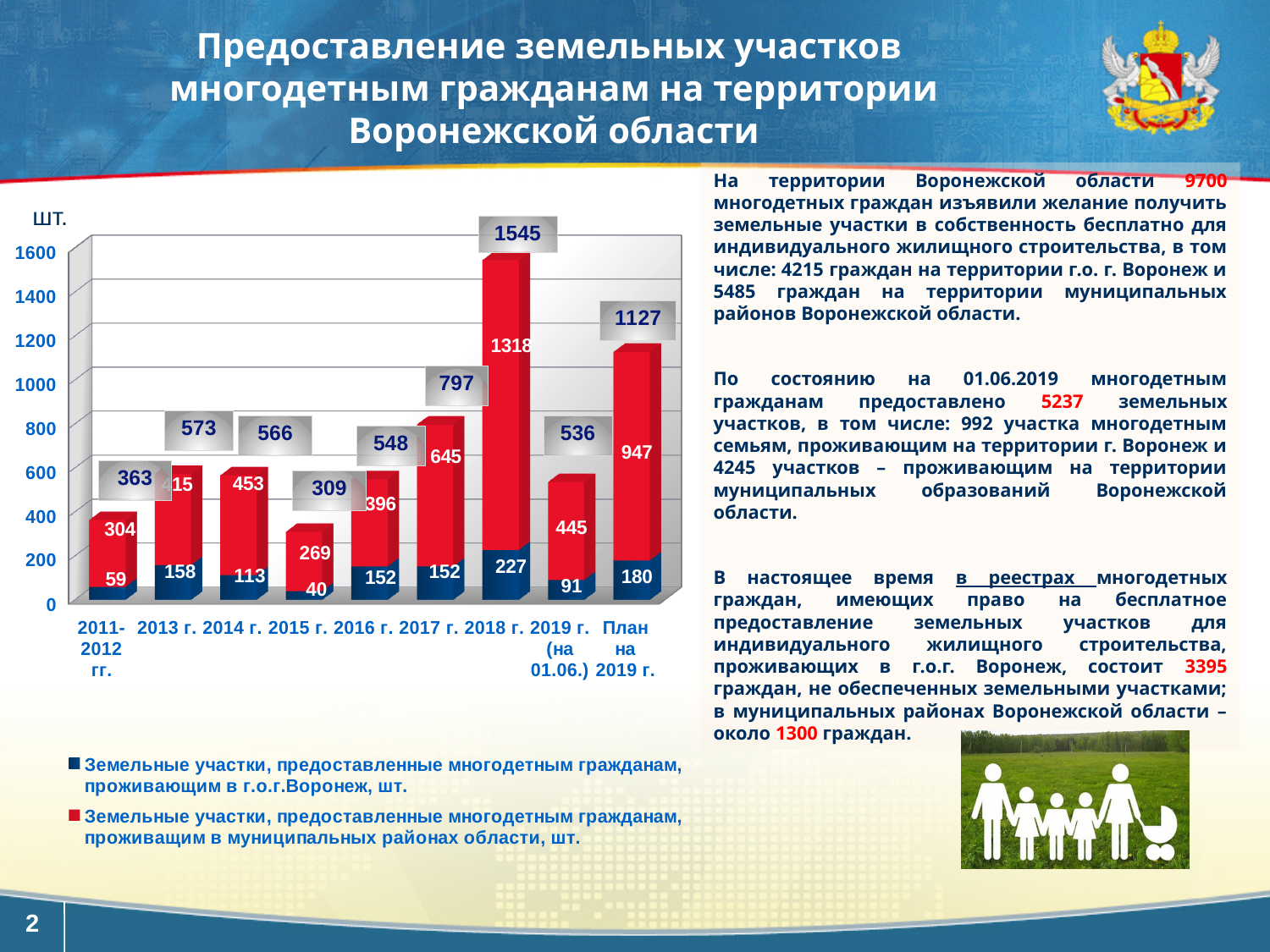
How many series does the chart legend list? 2 What is the total value shown above the bar for 2018 г.? 1545 What is the value for land plots provided to large families living in municipal districts in 2017 г.? 645 Which category has the highest total value? 2018 г. Is the total value for 2016 г. greater or less than 600? less What kind of chart is shown on the slide? stacked bar chart What is the value for land plots provided to large families living in г.о.г. Воронеж in 2014 г.? 113 What unit is shown at the top of the vertical axis? шт. How many categories are shown along the x axis of the chart? 9 What is the difference between the total for План на 2019 г. and the total for 2019 г. (на 01.06.)? 591 Which category has the lowest total value? 2015 г. Which is larger: the value for г.о.г. Воронеж in 2018 г. or in 2016 г.? 2018 г.